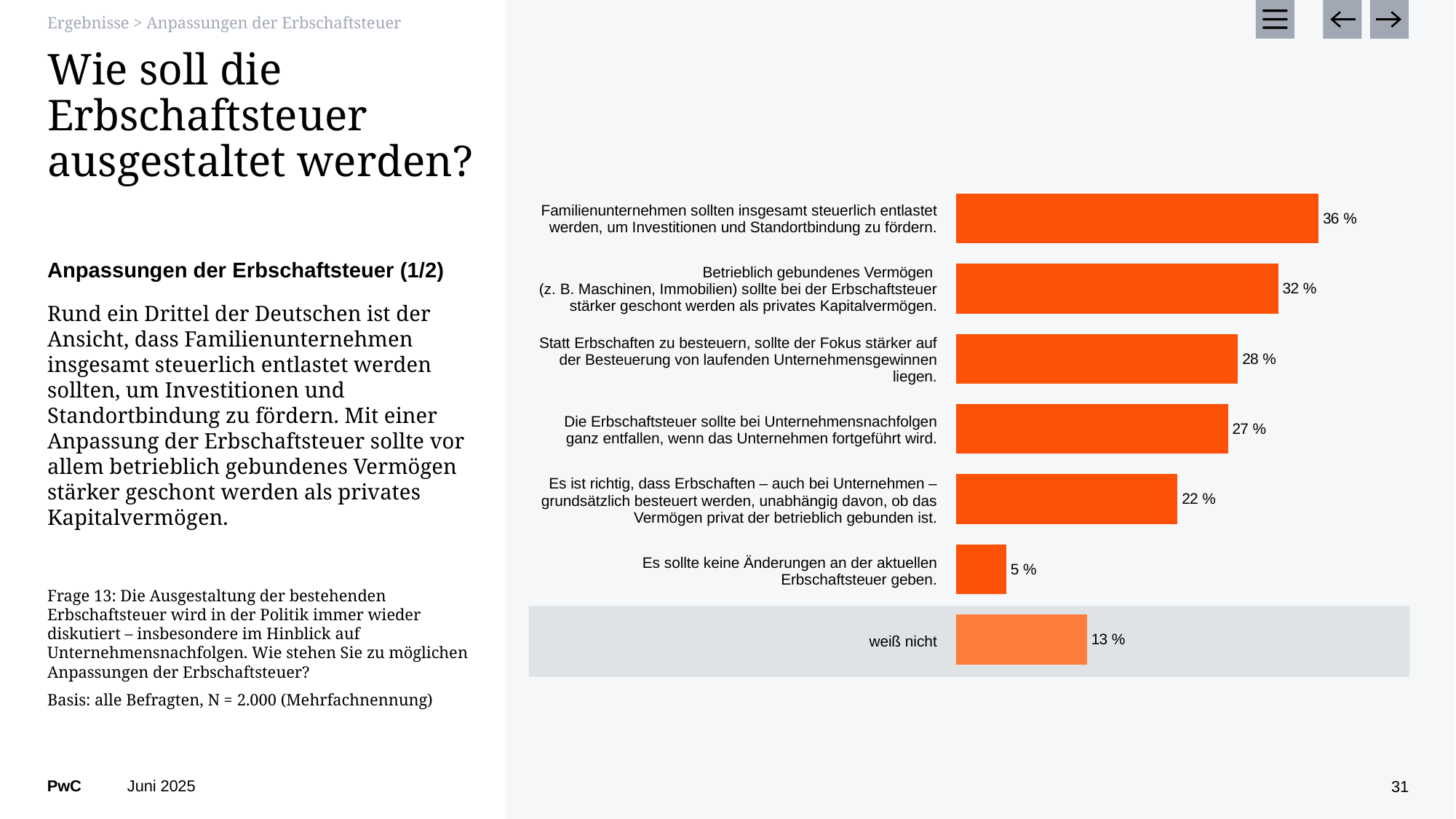
Which category has the lowest percentage in the chart? Es sollte keine Änderungen an der aktuellen Erbschaftsteuer geben. What type of chart is shown on the slide? Bar chart How many categories (bars) are shown in the chart? 7 What is the difference between the "weiß nicht" value and the "Es sollte keine Änderungen an der aktuellen Erbschaftsteuer geben." value? 8 percentage points What is the value for the statement that business-bound assets should be protected more strongly than private capital assets ("Betrieblich gebundenes Vermögen...")? 32 % What percentage of respondents agree that family businesses should be relieved of taxes overall to promote investment and location loyalty ("Familienunternehmen sollten insgesamt steuerlich entlastet werden...")? 36 % What share of respondents answered "weiß nicht"? 13 % Which bar is shown in a lighter orange shade with a grey background band? weiß nicht Which is larger: the value for "Statt Erbschaften zu besteuern, sollte der Fokus stärker auf der Besteuerung von laufenden Unternehmensgewinnen liegen." or the value for "Es ist richtig, dass Erbschaften – auch bei Unternehmen – grundsätzlich besteuert werden..."? Statt Erbschaften zu besteuern, sollte der Fokus stärker auf der Besteuerung von laufenden Unternehmensgewinnen liegen. What is the difference in percentage points between the top statement (36 %) and the statement that inheritance tax should be dropped entirely for business successions (27 %)? 9 percentage points Which statement has the highest percentage in the chart? Familienunternehmen sollten insgesamt steuerlich entlastet werden, um Investitionen und Standortbindung zu fördern. What is the value for "Es sollte keine Änderungen an der aktuellen Erbschaftsteuer geben."? 5 %